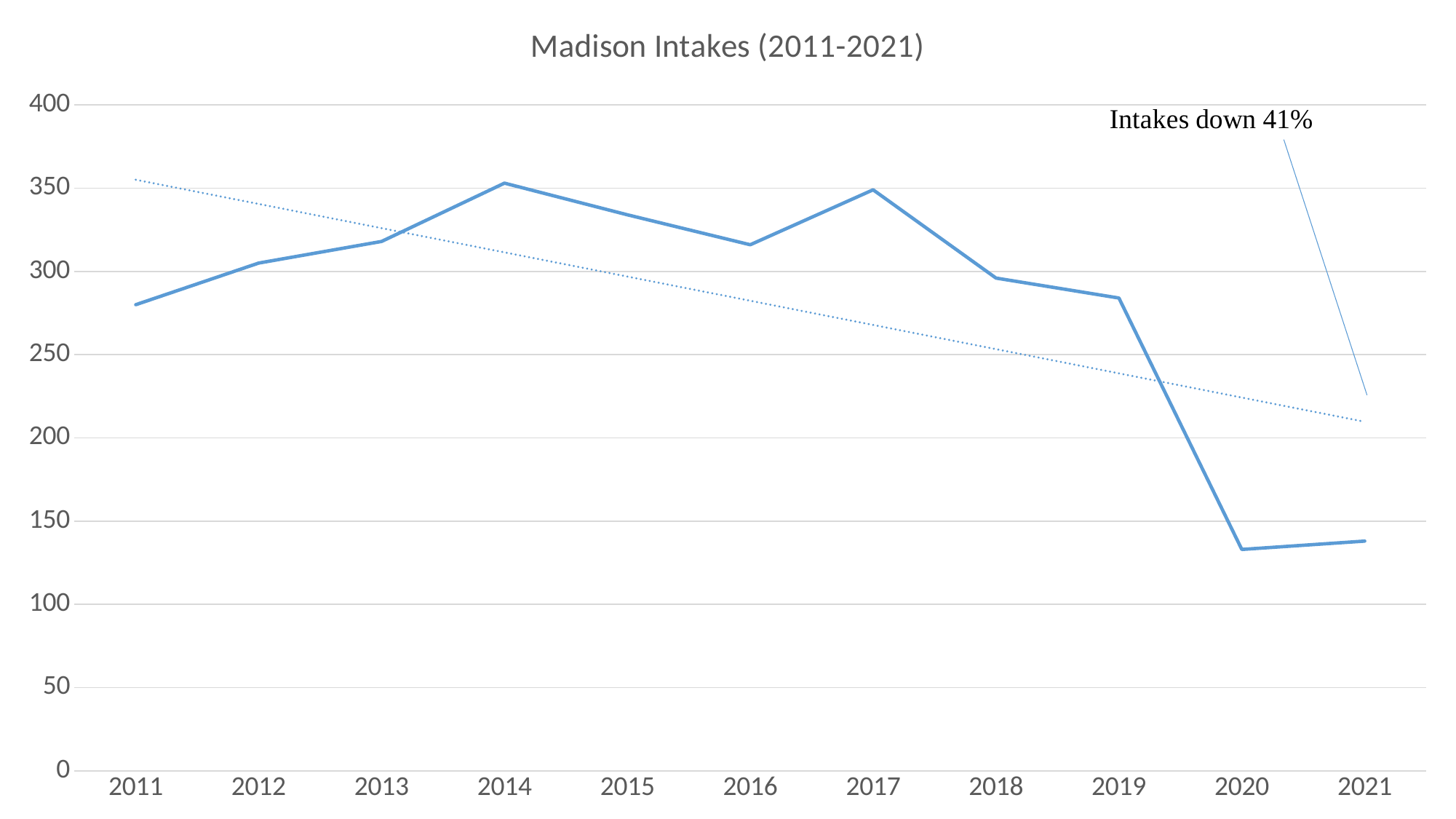
What kind of chart is shown on the slide? line chart Is the value for 2011 greater or less than 300? less What is the title of the chart? Madison Intakes (2011-2021) Is the value for 2019 greater or less than 250? greater Is the value for 2020 greater or less than 150? less Do the intake values overall rise or fall from 2011 to 2021? fall What does the text annotation on the chart say? Intakes down 41% How many years are plotted along the x axis? 11 Which year has the larger value, 2019 or 2020? 2019 Which year has the larger value, 2011 or 2014? 2014